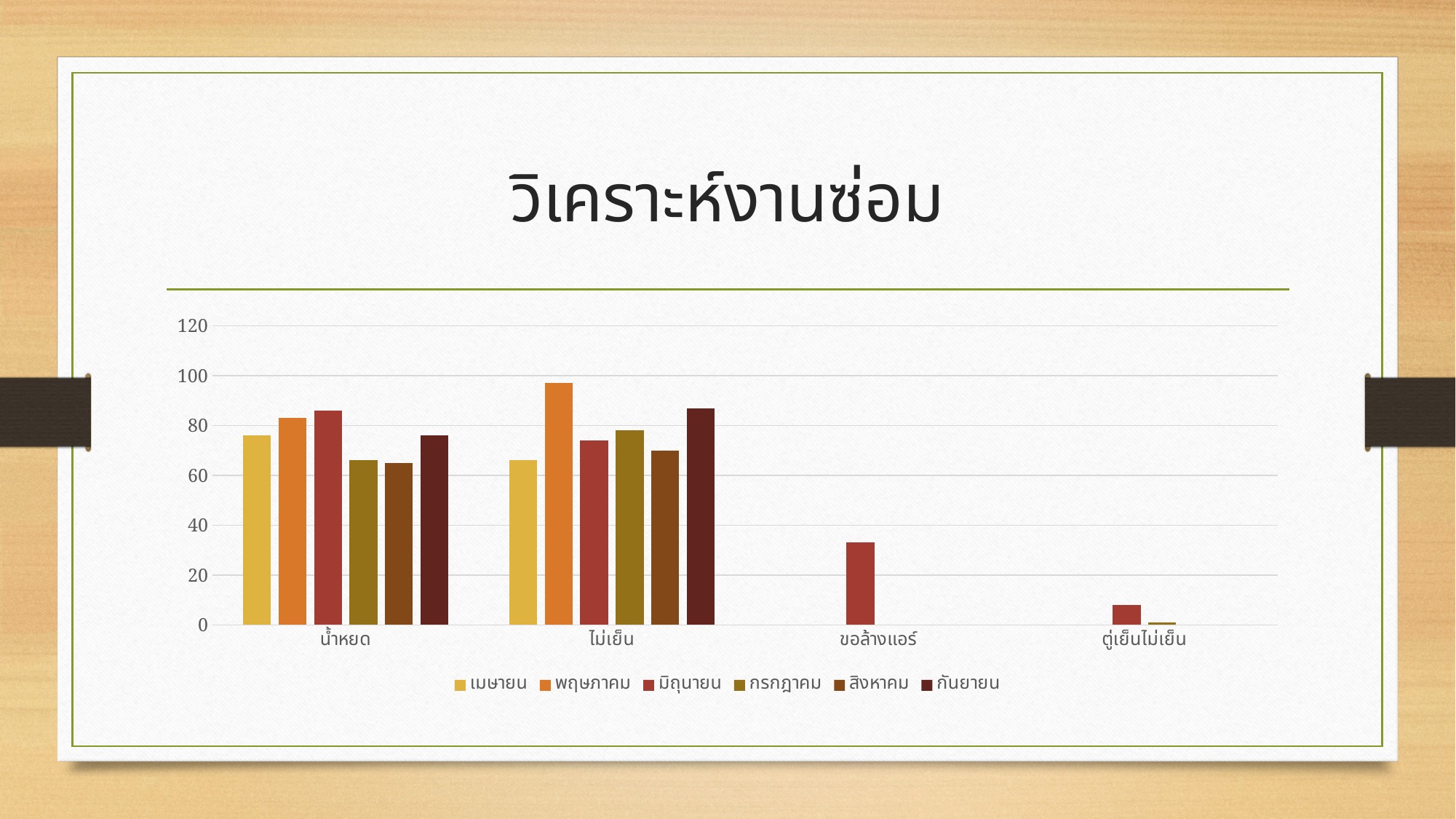
Which series has the lowest value in the ไม่เย็น category? เมษายน In the น้ำหยด category, which is larger: มิถุนายน or กรกฎาคม? มิถุนายน How many categories are shown on the x axis? 4 Is the value for พฤษภาคม in the ไม่เย็น category greater or less than 80? greater What is the title of the chart? วิเคราะห์งานซ่อม How many series does the legend list? 6 For the มิถุนายน series, which category has the larger value: ขอล้างแอร์ or ตู้เย็นไม่เย็น? ขอล้างแอร์ Is the value for เมษายน in the น้ำหยด category greater or less than 60? greater What kind of chart is shown on the slide? bar chart Is the value for มิถุนายน in the ขอล้างแอร์ category greater or less than 40? less Which series has the highest value in the ไม่เย็น category? พฤษภาคม